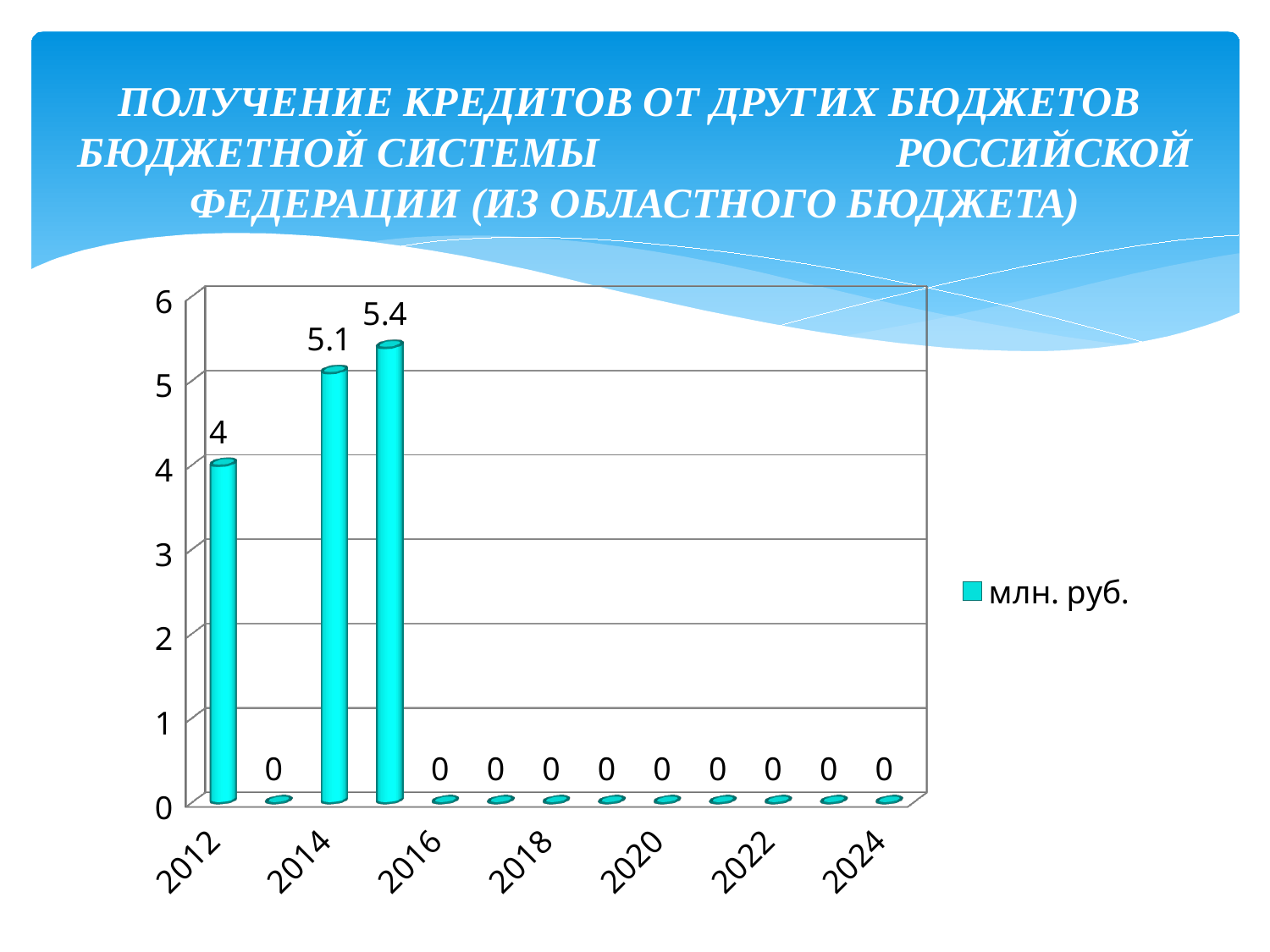
What is the legend entry for the series? млн. руб. What is the value for 2016? 0 Which year has the larger value, 2012 or 2014? 2014 What is the highest value shown on the chart? 5.4 How many bars are plotted on the chart? 13 What is the value for 2014? 5.1 What is the value for 2012? 4 What is the difference between the values for 2014 and 2012? 1.1 What kind of chart is shown on the slide? bar chart How many series does the legend list? 1 Is the value for 2012 greater or less than 3? greater What is the value for 2024? 0